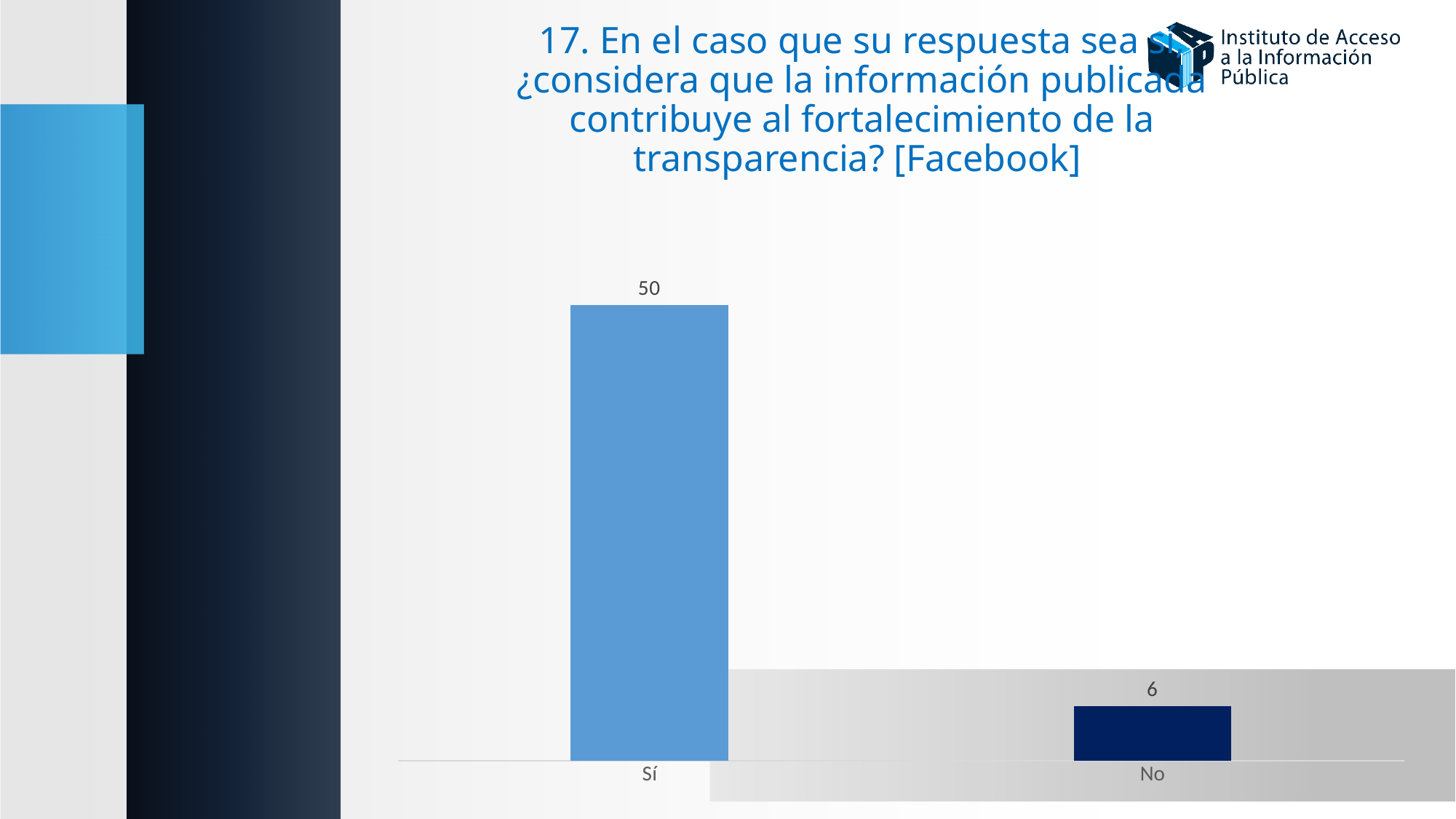
Which category has the highest value? Sí Which is larger, the value for "Sí" or the value for "No"? Sí What is the total of the values for "Sí" and "No"? 56 What colour is the bar for "No"? Dark navy blue How many categories are shown in the chart? 2 What kind of chart is shown on the slide? Bar chart What is the value for "Sí"? 50 What is the value for "No"? 6 Which social network is named in brackets in the chart title? Facebook Which category has the lowest value? No What is the difference between the values for "Sí" and "No"? 44